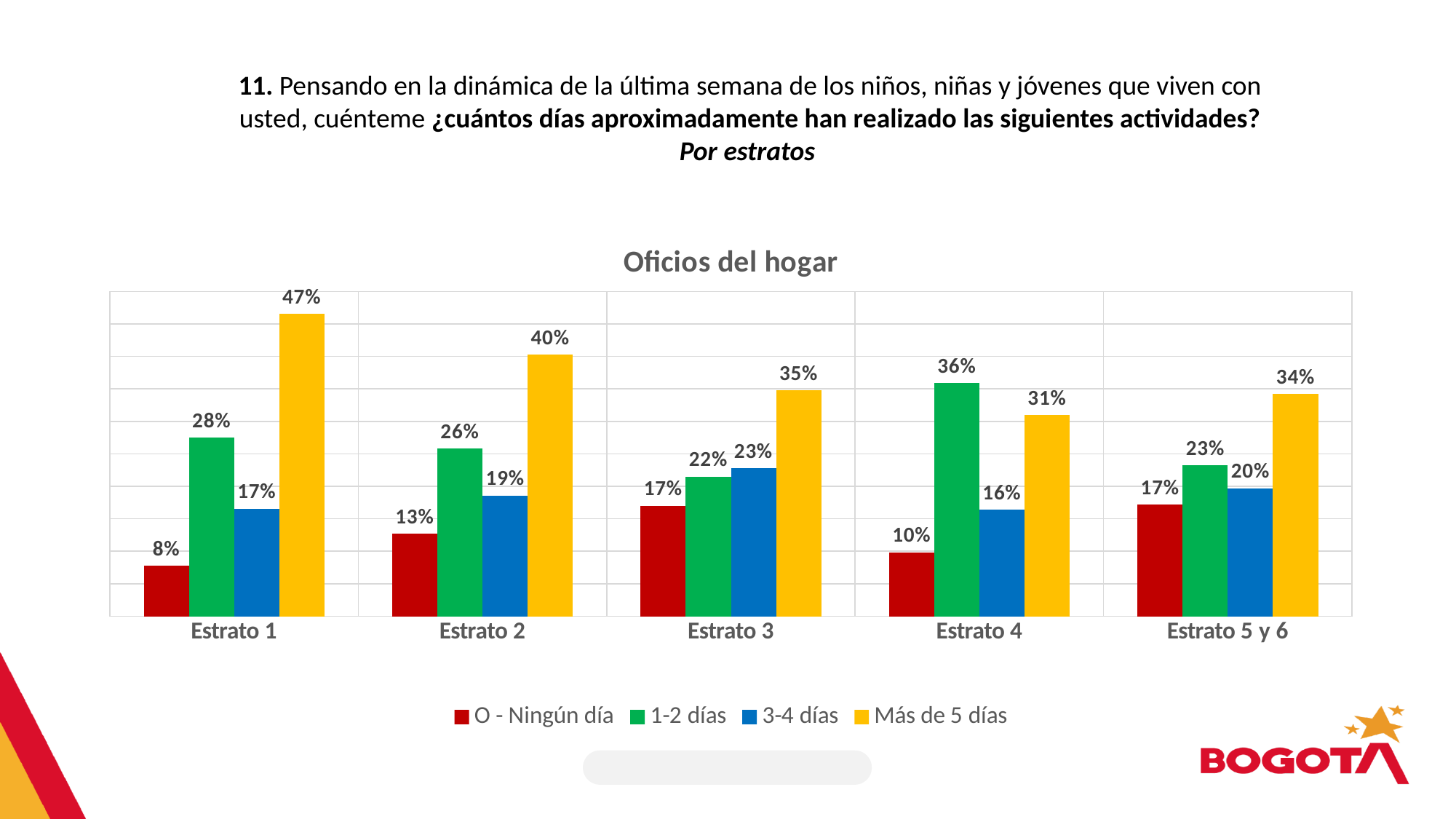
Which category has the lowest value for '0 - Ningún día'? Estrato 1 Which category has the highest value for 'Más de 5 días'? Estrato 1 What is the value for '0 - Ningún día' in Estrato 4? 10% What kind of chart is shown? Bar chart What is the value for '3-4 días' in Estrato 3? 23% What is the title of the chart? Oficios del hogar Which is larger in Estrato 4: '1-2 días' or 'Más de 5 días'? 1-2 días What is the difference between 'Más de 5 días' and '0 - Ningún día' in Estrato 2? 27% What is the value for 'Más de 5 días' in Estrato 1? 47% How many series does the legend list? 4 How many categories are shown on the x axis? 5 What is the value for '1-2 días' in Estrato 5 y 6? 23%